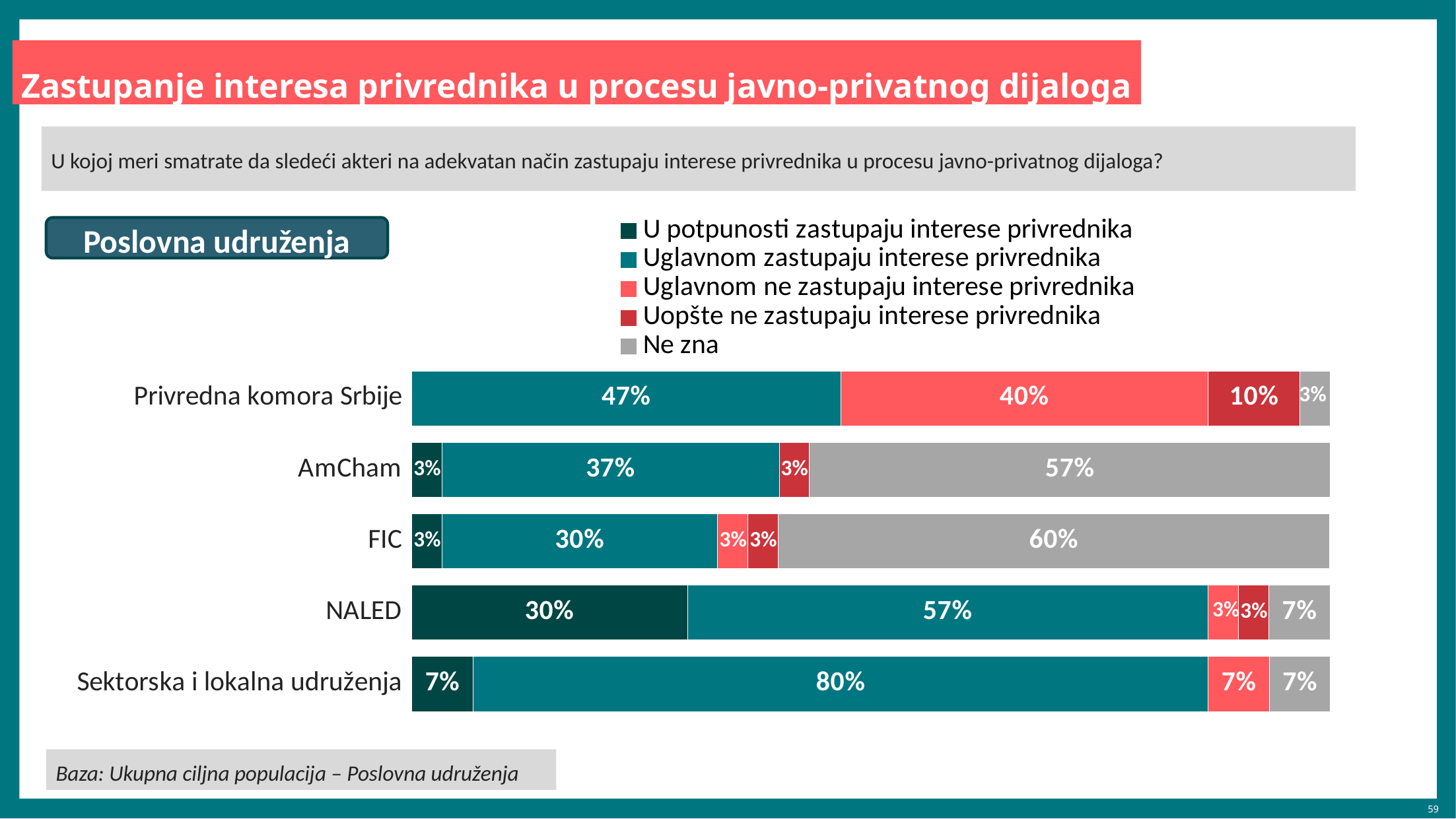
What kind of chart is shown on the slide? stacked bar chart What is the combined share of 'U potpunosti' and 'Uglavnom zastupaju interese privrednika' for NALED? 87% What is the 'U potpunosti zastupaju interese privrednika' value for NALED? 30% How many categories (actors) are plotted on the chart? 5 What is the difference between the 'Ne zna' values for FIC and AmCham? 3% Which actor has the highest 'Uglavnom zastupaju interese privrednika' value? Sektorska i lokalna udruženja What is the 'Uglavnom ne zastupaju interese privrednika' value for Privredna komora Srbije? 40% How many series does the legend list? 5 Which actor has the highest 'Ne zna' value? FIC Which is larger: the 'Uglavnom zastupaju interese privrednika' value for NALED or for AmCham? NALED What is the value of 'Uglavnom zastupaju interese privrednika' for Privredna komora Srbije? 47% What is the 'Ne zna' value for FIC? 60%